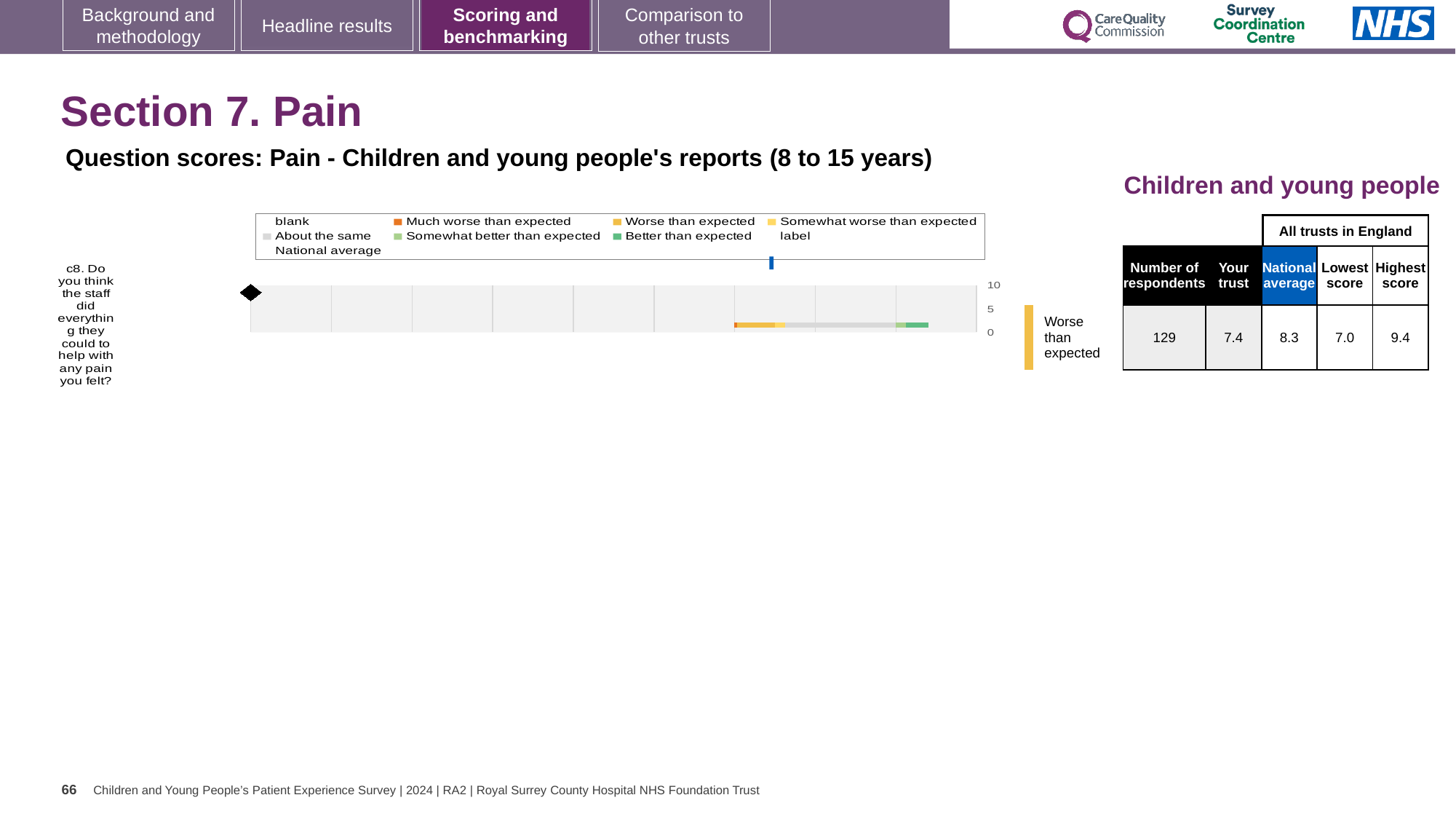
What is the 'Your trust' score for question c8 (Do you think the staff did everything they could to help with any pain you felt?)? 7.4 What colour represents 'Better than expected' in the chart legend? Green Which benchmark category is the trust's result for question c8 labelled as? Worse than expected What is the difference between the national average and the 'Your trust' score for question c8? 0.9 What is the national average score for question c8? 8.3 Which is larger for question c8: the 'Your trust' score or the national average? National average What kind of chart is used to show the c8 question score? bar chart What is the highest score among all trusts in England for question c8? 9.4 How many survey questions are plotted on the chart? 1 How many respondents answered question c8? 129 What is the lowest score among all trusts in England for question c8? 7.0 What is the difference between the highest score and the lowest score for question c8? 2.4